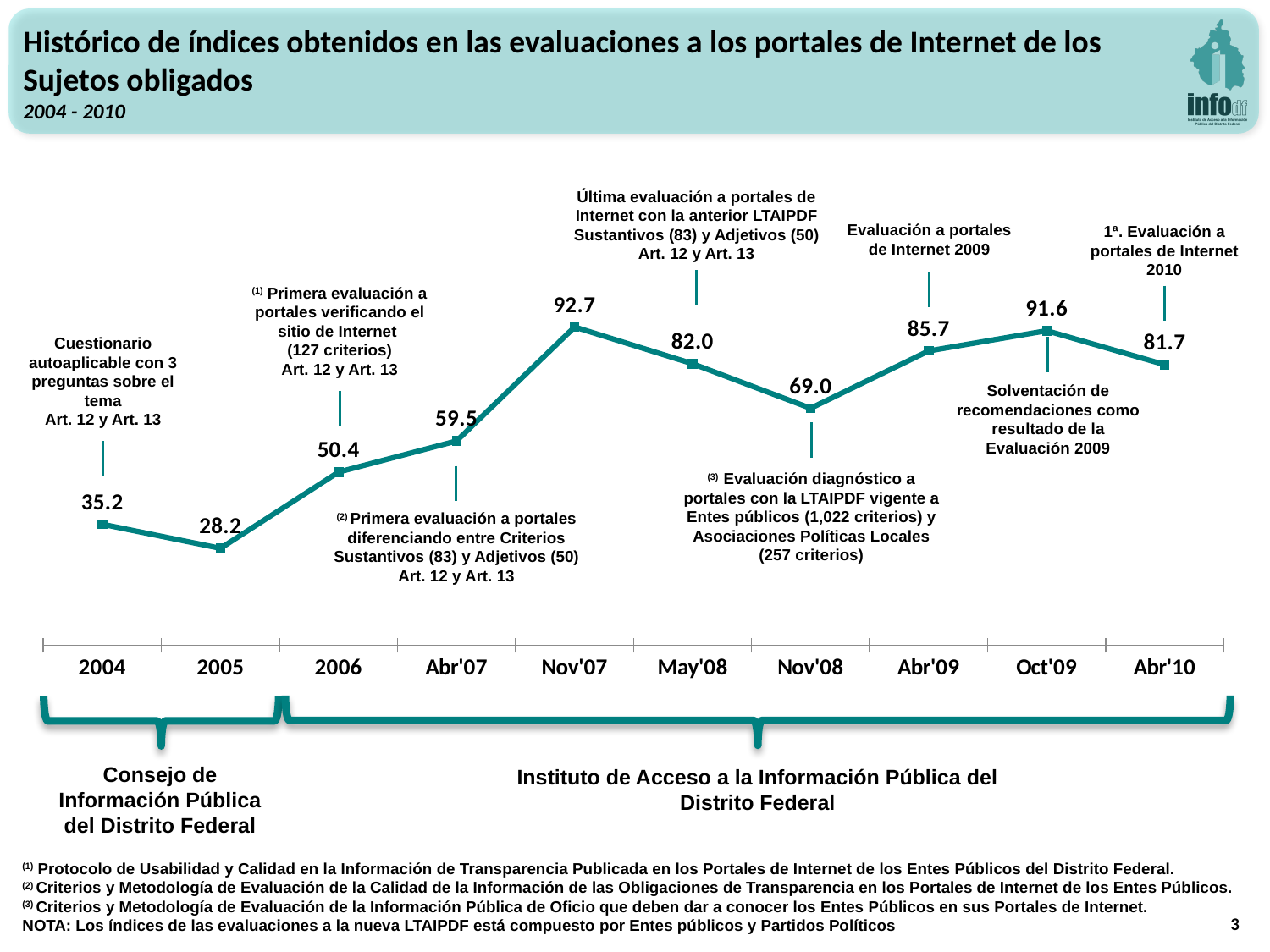
What period does the chart title indicate the data covers? 2004 - 2010 How many data points are plotted on the line? 10 What is the index value for Nov'08? 69.0 Which point on the x axis has the highest index value? Nov'07 What is the index value for 2004? 35.2 Does the index value rise or fall from 2005 to Nov'07? Rise What is the index value for Abr'10? 81.7 What type of chart is shown on the slide? Line chart What is the difference between the index values for Nov'07 and May'08? 10.7 Which point on the x axis has the lowest index value? 2005 Which is larger, the index value for Oct'09 or for Abr'09? Oct'09 What is the difference between the index values for 2006 and 2005? 22.2